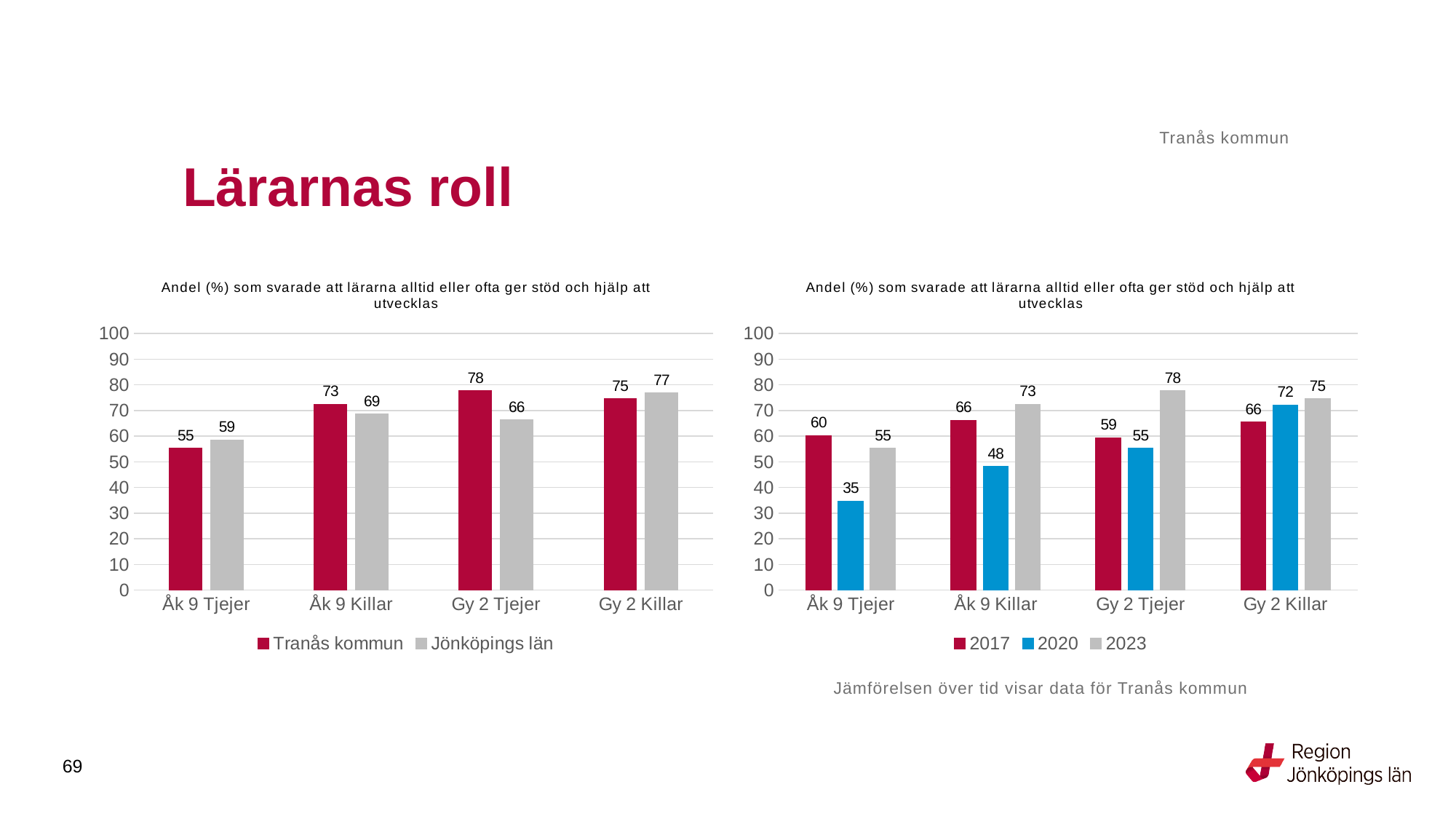
In the right chart, which category has the highest value for 2023? Gy 2 Tjejer In the left chart, what is the value for Tranås kommun for Gy 2 Tjejer? 78 In the right chart, what is the difference between the 2023 and 2020 values for Åk 9 Killar? 25 In the right chart, what is the value for 2017 for Gy 2 Killar? 66 In the left chart, what is the difference between Tranås kommun and Jönköpings län for Gy 2 Tjejer? 12 In the right chart, what is the value for 2020 for Åk 9 Tjejer? 35 How many categories are shown on the x axis of the left chart? 4 How many series does the legend of the right chart list? 3 In the left chart, which category has the lowest value for Tranås kommun? Åk 9 Tjejer In the left chart, which is larger for Åk 9 Tjejer: Tranås kommun or Jönköpings län? Jönköpings län In the left chart, what is the value for Jönköpings län for Åk 9 Killar? 69 What kind of chart is the right chart? Bar chart